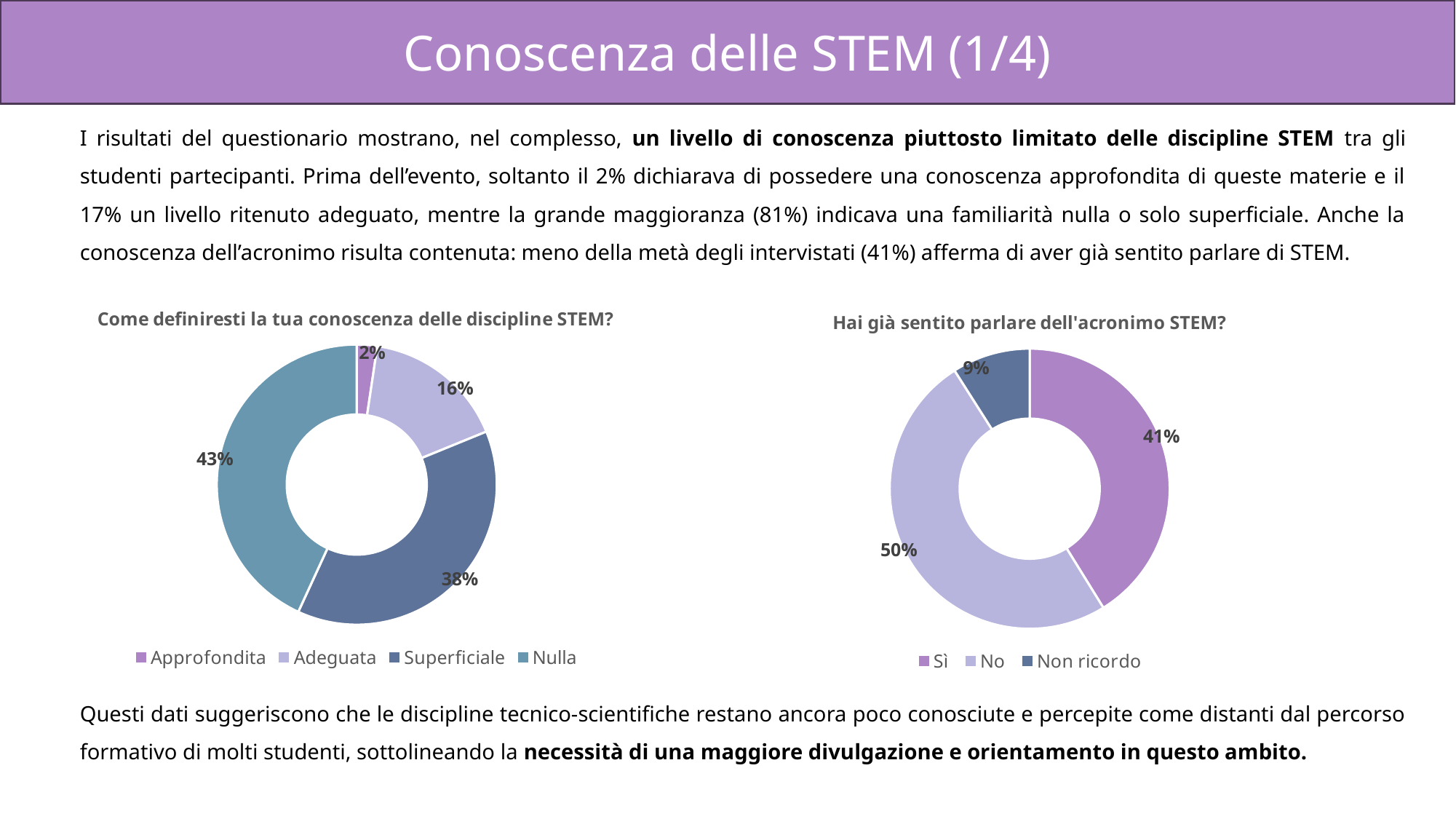
In the chart 'Come definiresti la tua conoscenza delle discipline STEM?', which category has the smallest share? Approfondita In the chart 'Hai già sentito parlare dell'acronimo STEM?', what percentage answered Sì? 41% In the chart 'Come definiresti la tua conoscenza delle discipline STEM?', which category has the largest share? Nulla In the chart 'Come definiresti la tua conoscenza delle discipline STEM?', how many categories does the legend list? 4 In the chart 'Come definiresti la tua conoscenza delle discipline STEM?', what percentage is shown for Nulla? 43% In the chart 'Come definiresti la tua conoscenza delle discipline STEM?', what percentage is shown for Adeguata? 16% In the chart 'Come definiresti la tua conoscenza delle discipline STEM?', what is the difference in percentage points between Superficiale and Adeguata? 22 In the chart 'Hai già sentito parlare dell'acronimo STEM?', which answer has the largest share? No What type of chart is used for 'Hai già sentito parlare dell'acronimo STEM?'? Doughnut (pie) chart In the chart 'Hai già sentito parlare dell'acronimo STEM?', what percentage answered Non ricordo? 9% In the chart 'Hai già sentito parlare dell'acronimo STEM?', which is larger, Sì or No? No In the chart 'Hai già sentito parlare dell'acronimo STEM?', what colour is the Sì slice? Purple